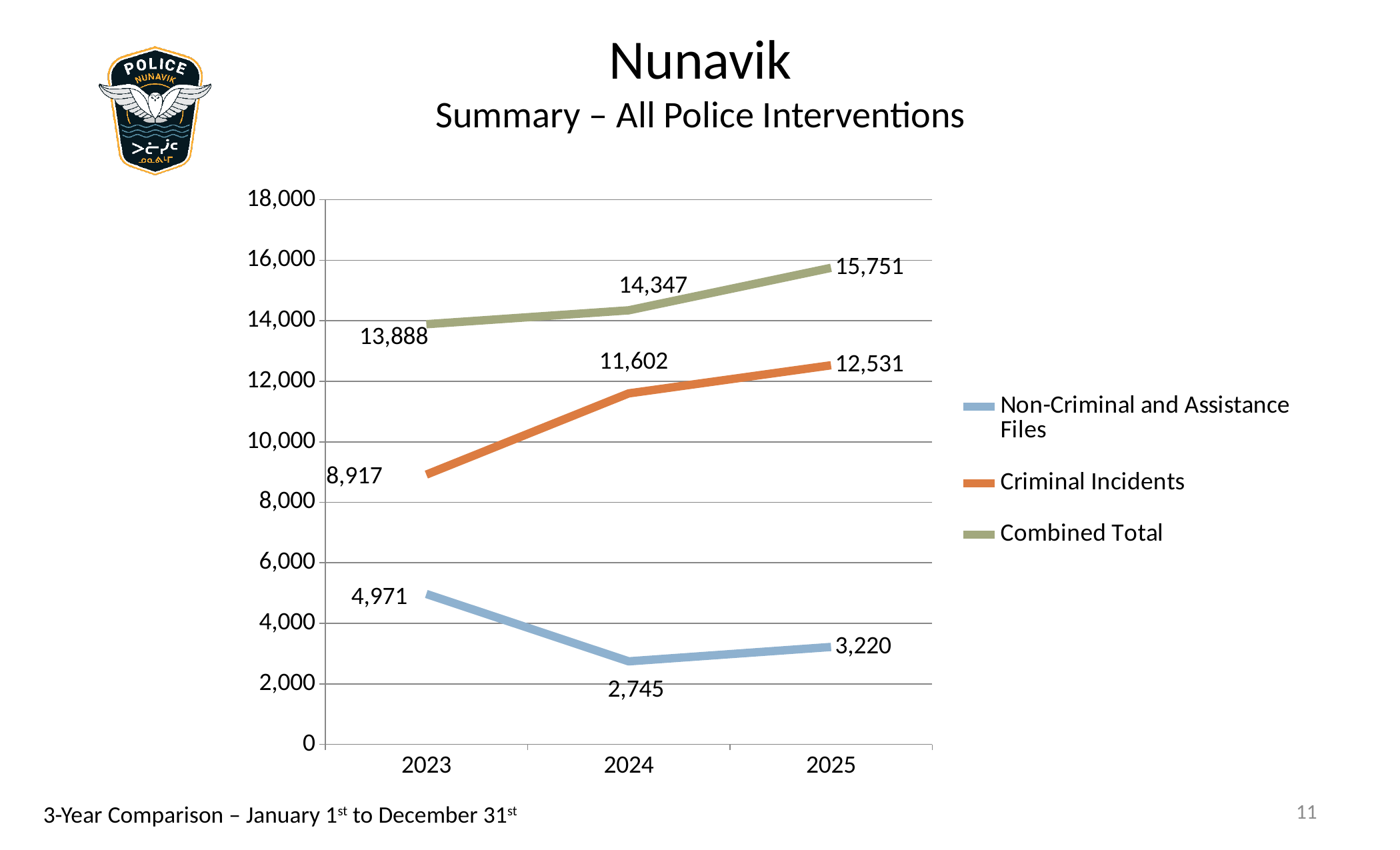
Which is larger: Criminal Incidents in 2023 or Criminal Incidents in 2025? Criminal Incidents in 2025 What is the value for Criminal Incidents in 2024? 11,602 What is the Combined Total for 2025? 15,751 Do the values for Criminal Incidents rise or fall from 2023 to 2025? rise How many series does the legend list? 3 What is the value for Non-Criminal and Assistance Files in 2023? 4,971 Is the value for Criminal Incidents in 2023 greater or less than 10,000? less In which year is the value for Non-Criminal and Assistance Files lowest? 2024 How many years are shown on the x axis? 3 In which year is the Combined Total highest? 2025 What kind of chart is shown on the slide? line chart What is the difference between the Combined Total in 2025 and in 2023? 1,863